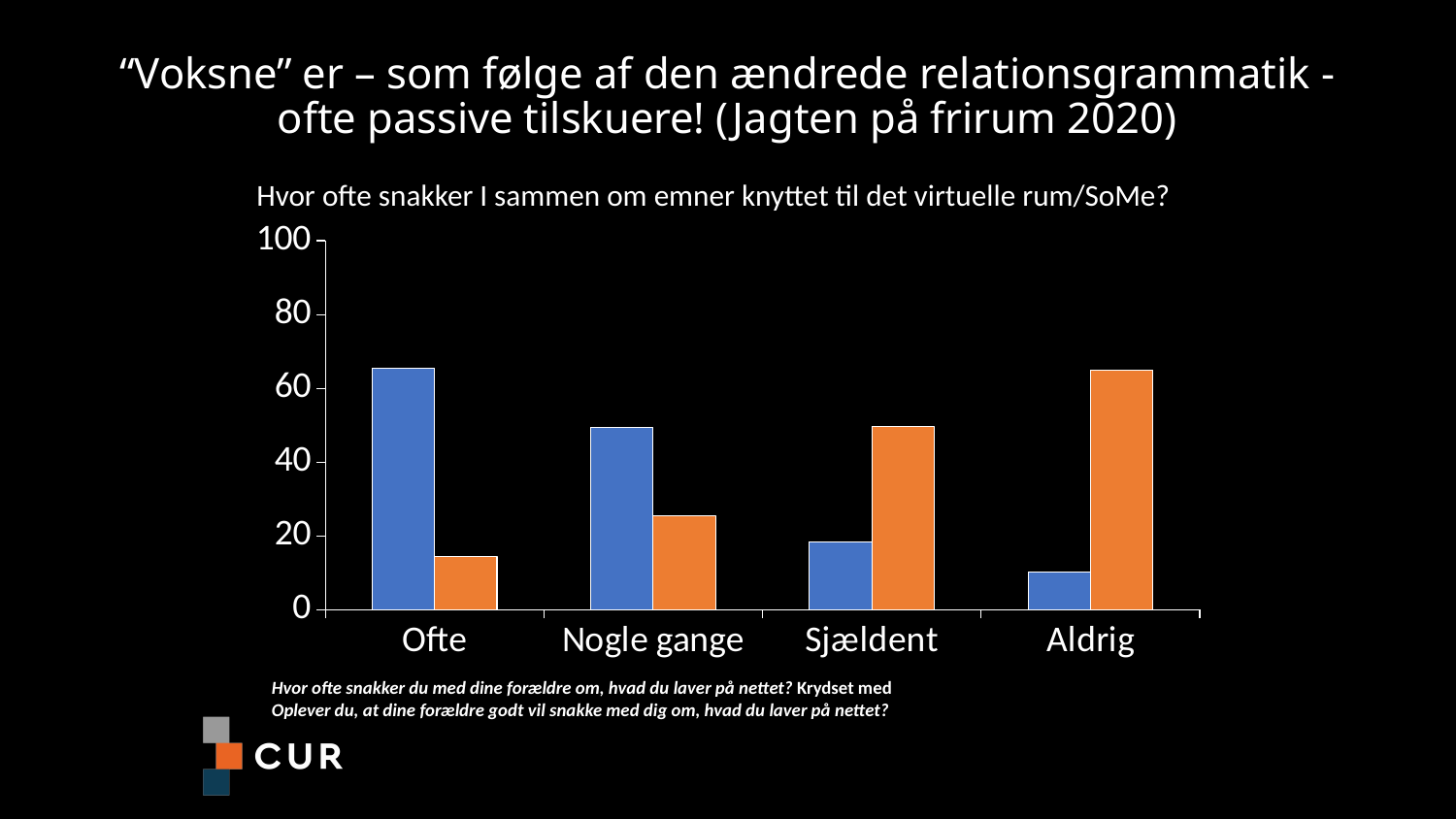
How many categories are shown on the x axis of the chart? 4 Is the blue bar for Ofte greater or less than 60? greater Do the blue bars rise or fall from Ofte to Aldrig along the x axis? fall Is the orange bar for Aldrig greater or less than 60? greater What kind of chart is shown on the slide? bar chart For which category is the blue bar highest? Ofte For which category is the orange bar highest? Aldrig For which category is the blue bar lowest? Aldrig Is the blue bar for Aldrig greater or less than 20? less In the Sjældent category, which bar is taller, the blue or the orange one? orange What is the title of the chart? Hvor ofte snakker I sammen om emner knyttet til det virtuelle rum/SoMe?